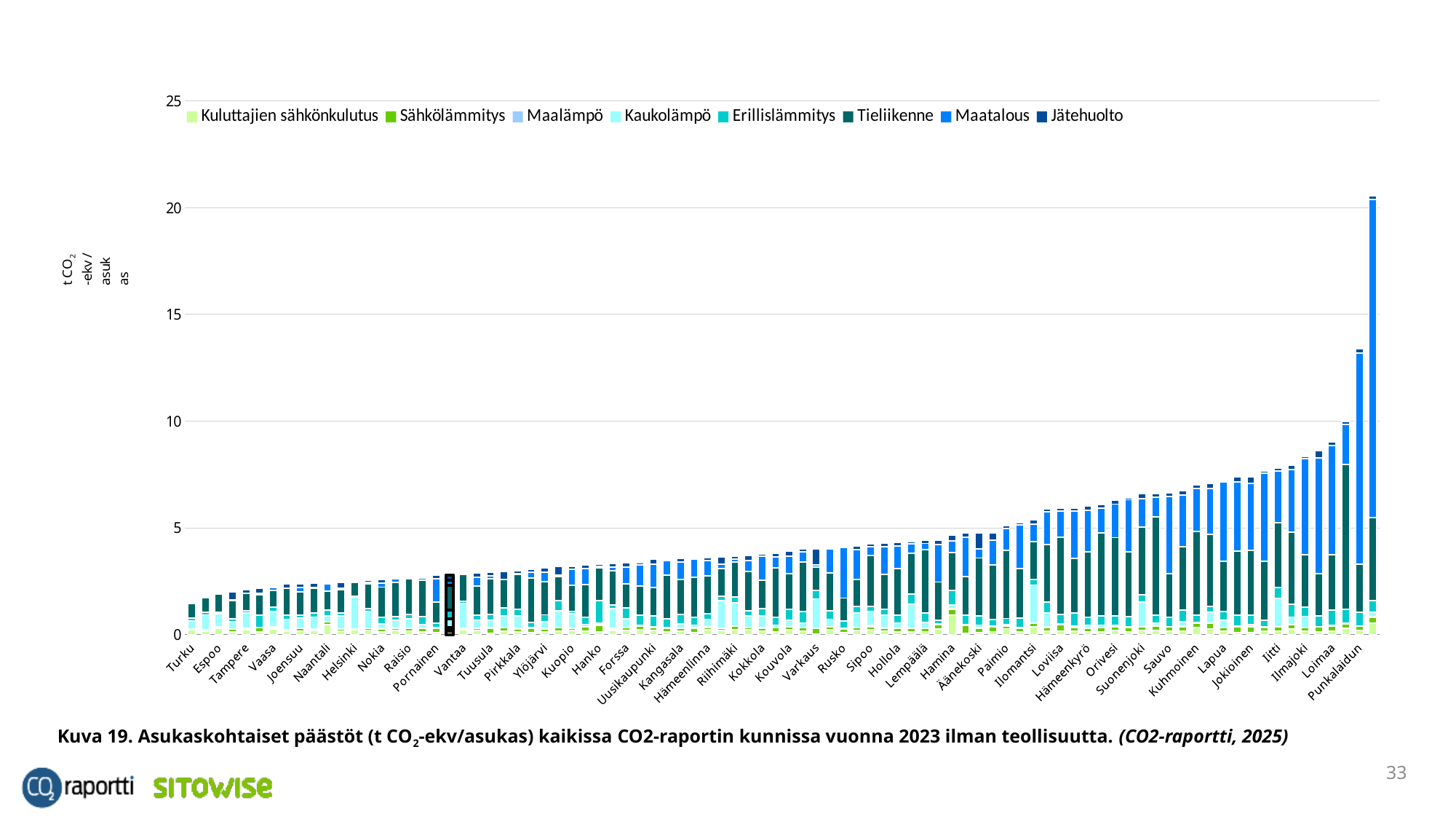
Which series is listed first in the legend? Kuluttajien sähkönkulutus How many series does the legend list? 8 What kind of chart is shown on the slide? Stacked bar chart Which municipality has the lowest total bar? Turku Which has a larger total bar, Loimaa or Espoo? Loimaa Is the total value for Helsinki greater or less than 5? less Which has a larger total bar, Punkalaidun or Turku? Punkalaidun Is the total value for Turku greater or less than 5? less Do the total bar heights generally rise or fall from left to right along the x axis? Rise Is the total value for Loimaa greater or less than 10? less